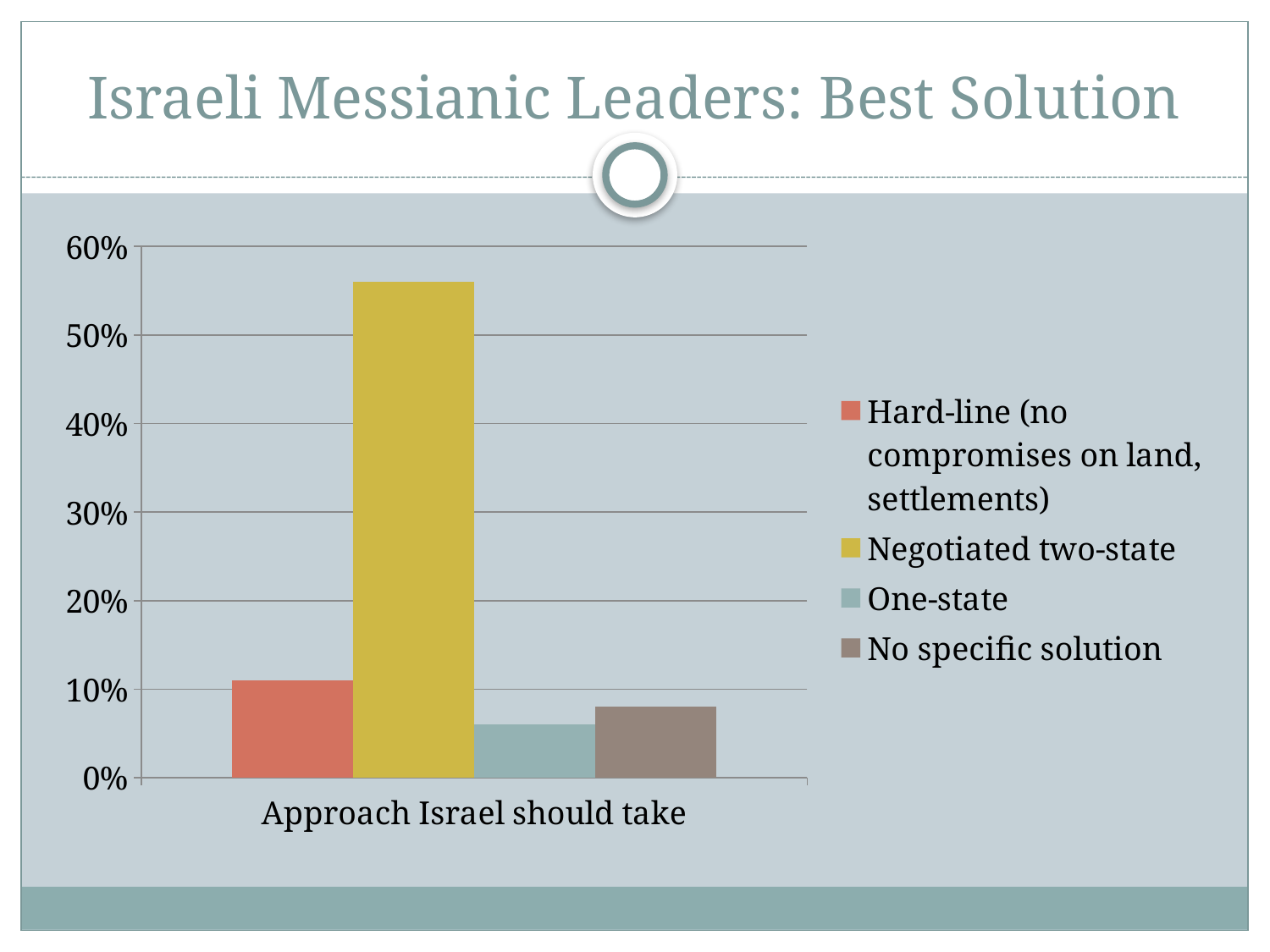
Which is larger, the value for Negotiated two-state or the value for No specific solution? Negotiated two-state What is the category label shown on the x axis? Approach Israel should take Is the value for No specific solution greater or less than 10%? less Is the value for One-state greater or less than 10%? less Is the value for Negotiated two-state greater or less than 50%? greater Which series has the lowest value? One-state What is the title of the slide? Israeli Messianic Leaders: Best Solution How many series does the legend list? 4 What kind of chart is shown on the slide? bar chart Which is larger, the value for Hard-line (no compromises on land, settlements) or the value for One-state? Hard-line (no compromises on land, settlements) Which series has the highest value? Negotiated two-state